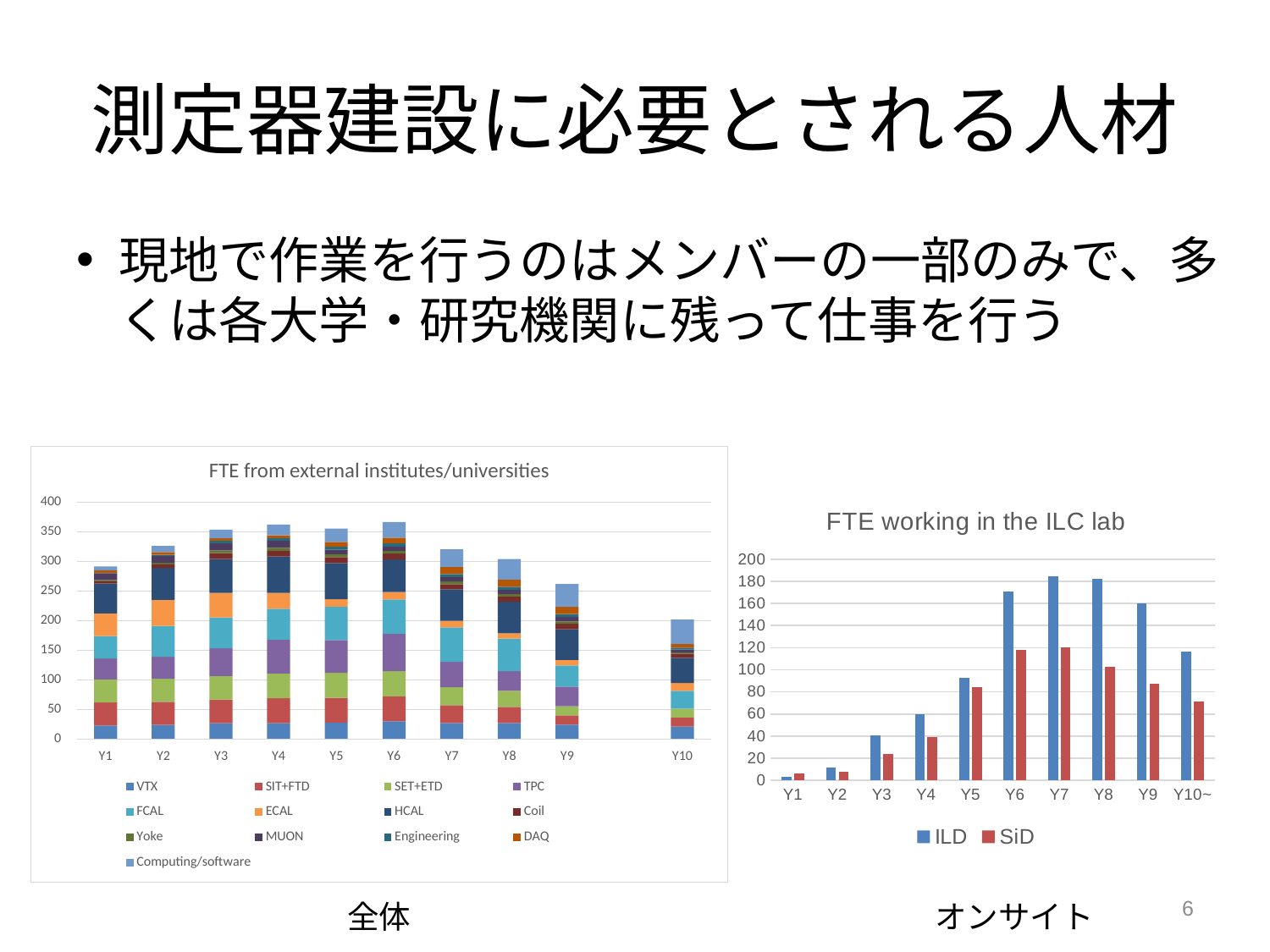
How many categories are shown on the x axis of the 'FTE working in the ILC lab' chart? 10 In the 'FTE from external institutes/universities' chart, which category has the lowest stacked total? Y10 In the 'FTE working in the ILC lab' chart, is the ILD value for Y6 greater or less than 160? greater In the 'FTE from external institutes/universities' chart, is the stacked total for Y10 greater or less than 250? less In the 'FTE working in the ILC lab' chart, which category has the lowest ILD value? Y1 In the 'FTE working in the ILC lab' chart, is the ILD value for Y5 greater or less than 100? less In the 'FTE working in the ILC lab' chart, which is larger at Y6, ILD or SiD? ILD How many series does the legend of the 'FTE from external institutes/universities' chart list? 13 What type of chart is the 'FTE working in the ILC lab' chart? bar chart In the 'FTE working in the ILC lab' chart, do the ILD values rise or fall from Y1 to Y7? rise How many series does the legend of the 'FTE working in the ILC lab' chart list? 2